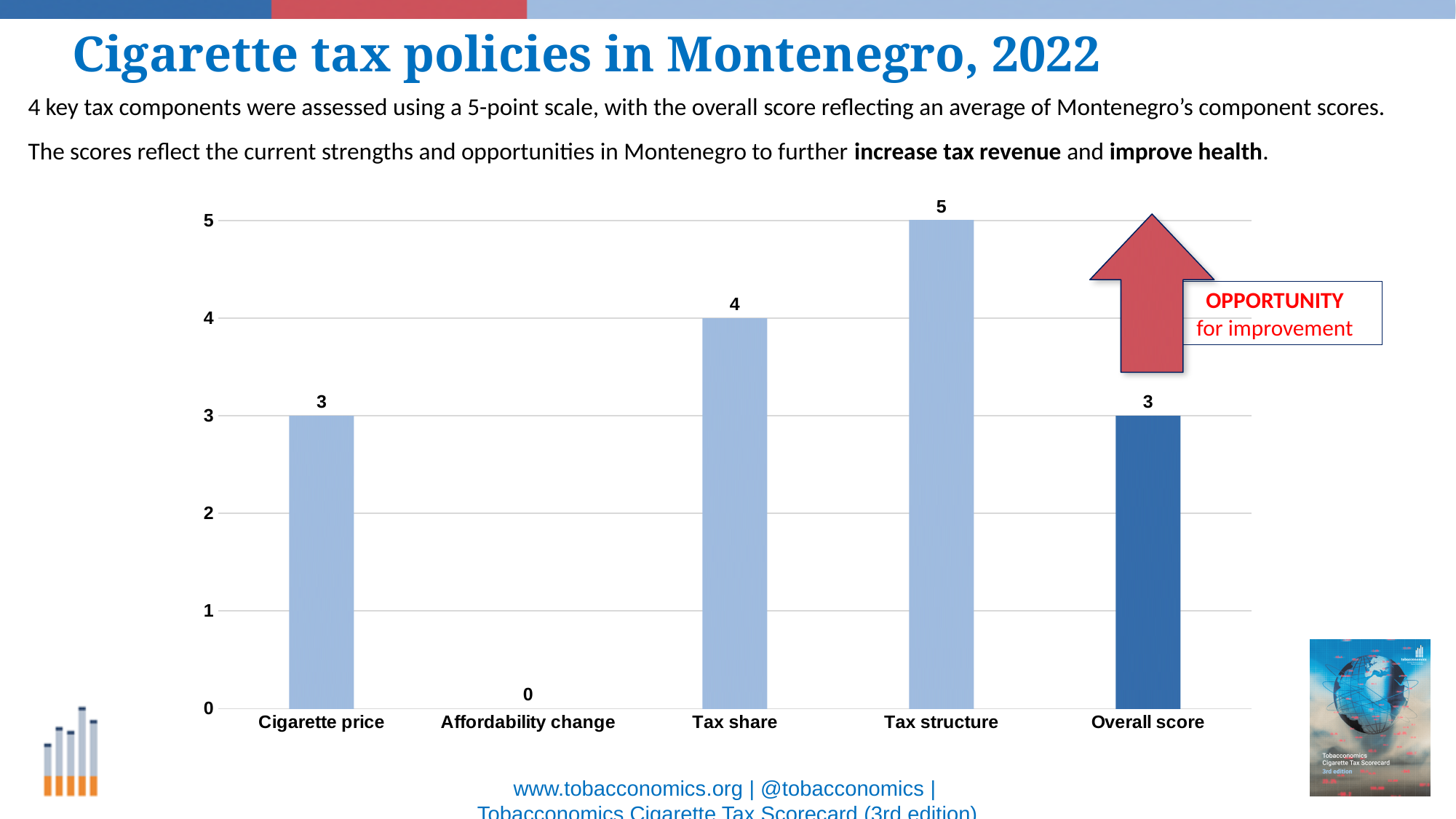
What is the score for Cigarette price? 3 What is the difference between the Tax structure score and the Tax share score? 1 Which component has the highest score? Tax structure Which component has the lowest score? Affordability change How many categories are shown on the x axis of the chart? 5 What is the score for Affordability change? 0 What is the score for Tax share? 4 Which is larger, the score for Tax share or the score for Cigarette price? Tax share What is the difference between the Tax structure score and the Overall score? 2 Which bar is shown in a darker blue than the others? Overall score What kind of chart is shown on the slide? Bar chart What is the Overall score shown in the chart? 3